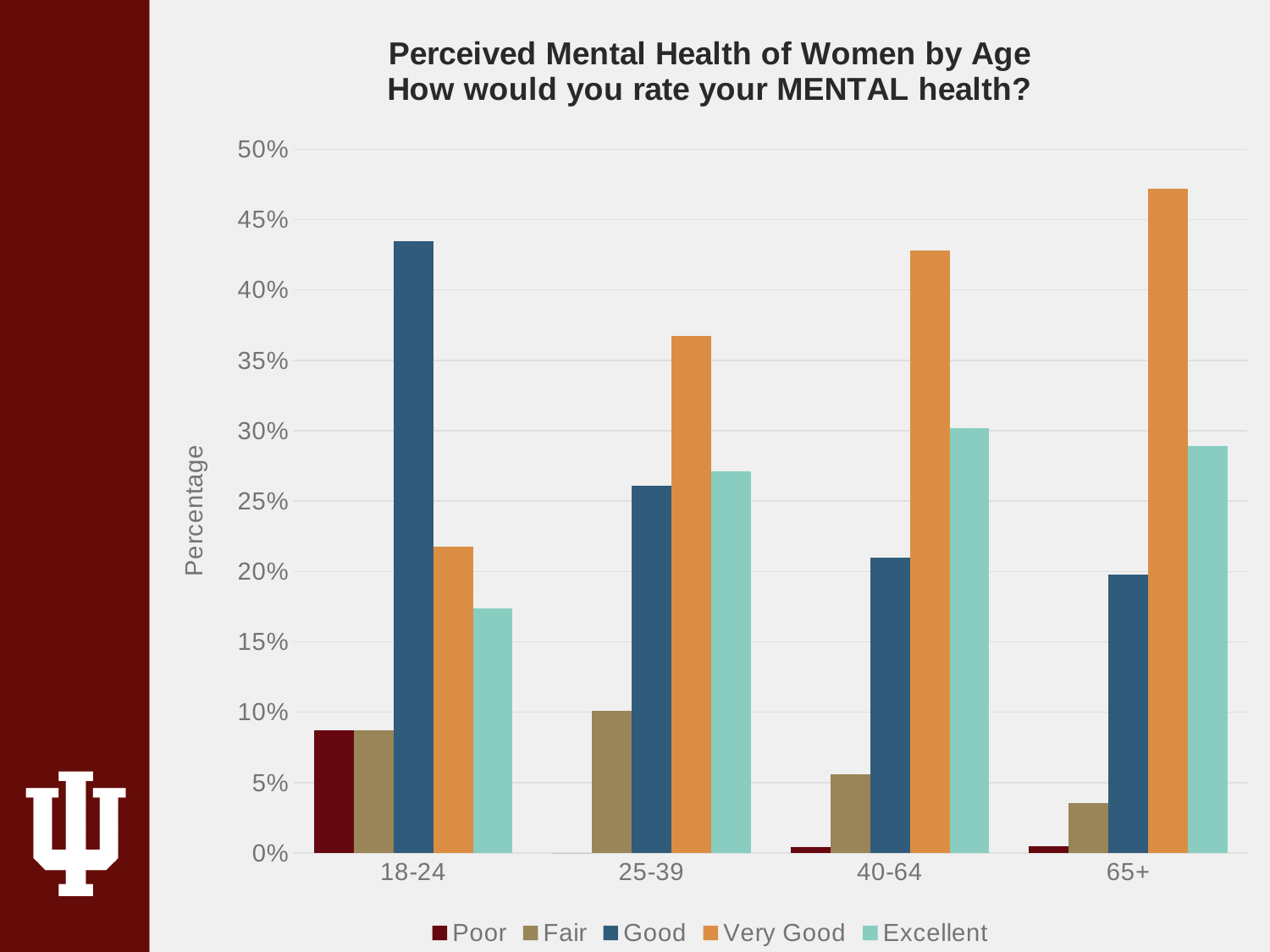
How many series does the legend list? 5 What is the label of the y axis? Percentage What type of chart is shown on the slide? bar chart Which age group has the highest value for Very Good? 65+ Is the value for Excellent in the 18-24 age group greater or less than 20%? less Which is larger: Good for 25-39 or Good for 40-64? Good for 25-39 Is the value for Very Good in the 25-39 age group greater or less than 35%? greater How many age groups are shown on the x axis? 4 Which age group has the lowest value for Fair? 65+ In the 18-24 age group, which rating has the highest value? Good Does the value for Very Good rise or fall as age group increases along the x axis? rise Is the value for Good in the 18-24 age group greater or less than 40%? greater